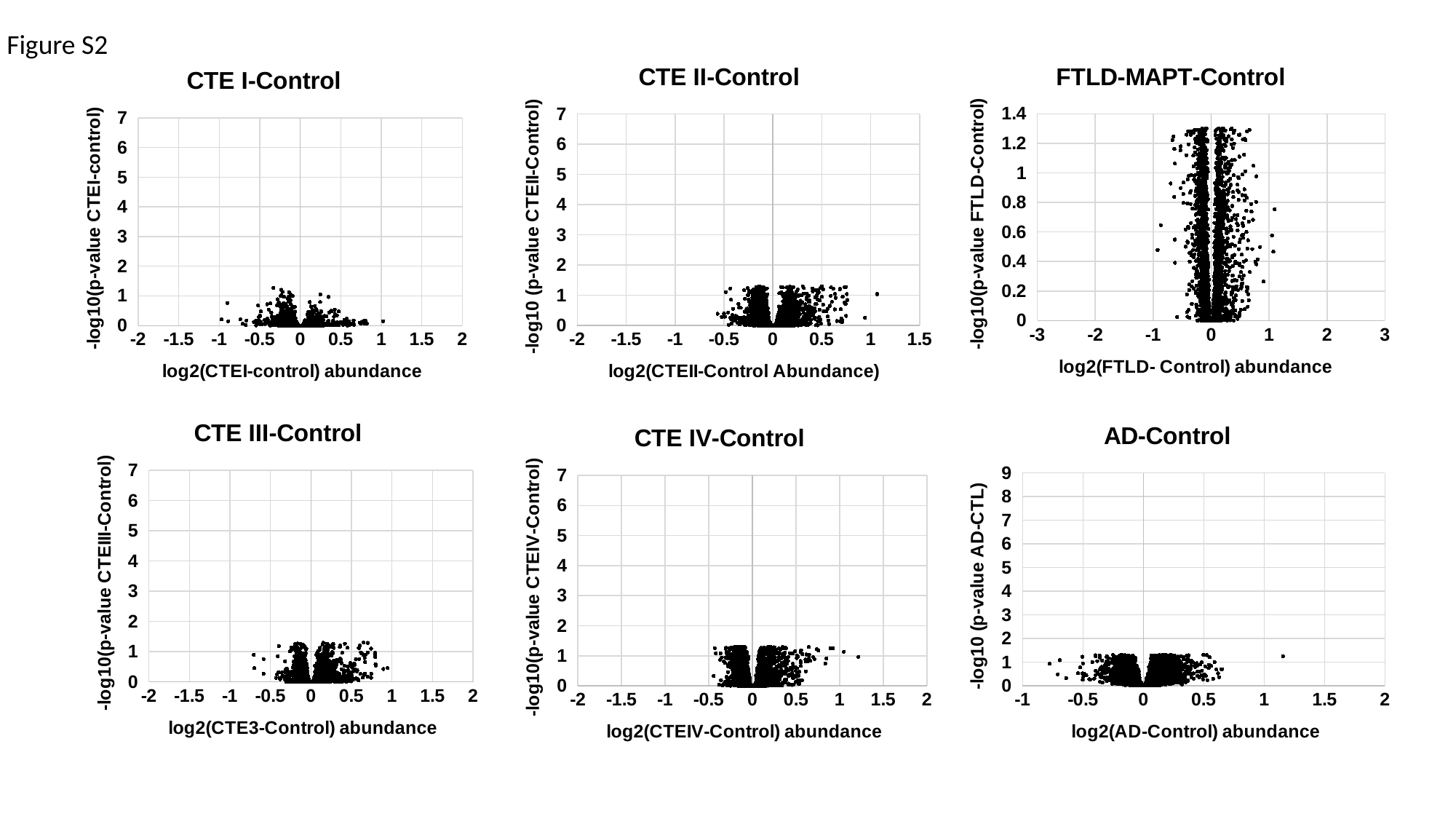
What is the x-axis label of the CTE III-Control chart? log2(CTE3-Control) abundance What is the title of the chart in the top right of the slide? FTLD-MAPT-Control In the CTE I-Control chart, is the highest point on the y axis greater or less than 2? less In the CTE III-Control chart, is the highest point on the y axis greater or less than 3? less In the AD-Control chart, is the rightmost point on the x axis greater or less than 1? greater What kind of chart is the CTE I-Control chart? scatter chart What kind of chart is the AD-Control chart? scatter chart